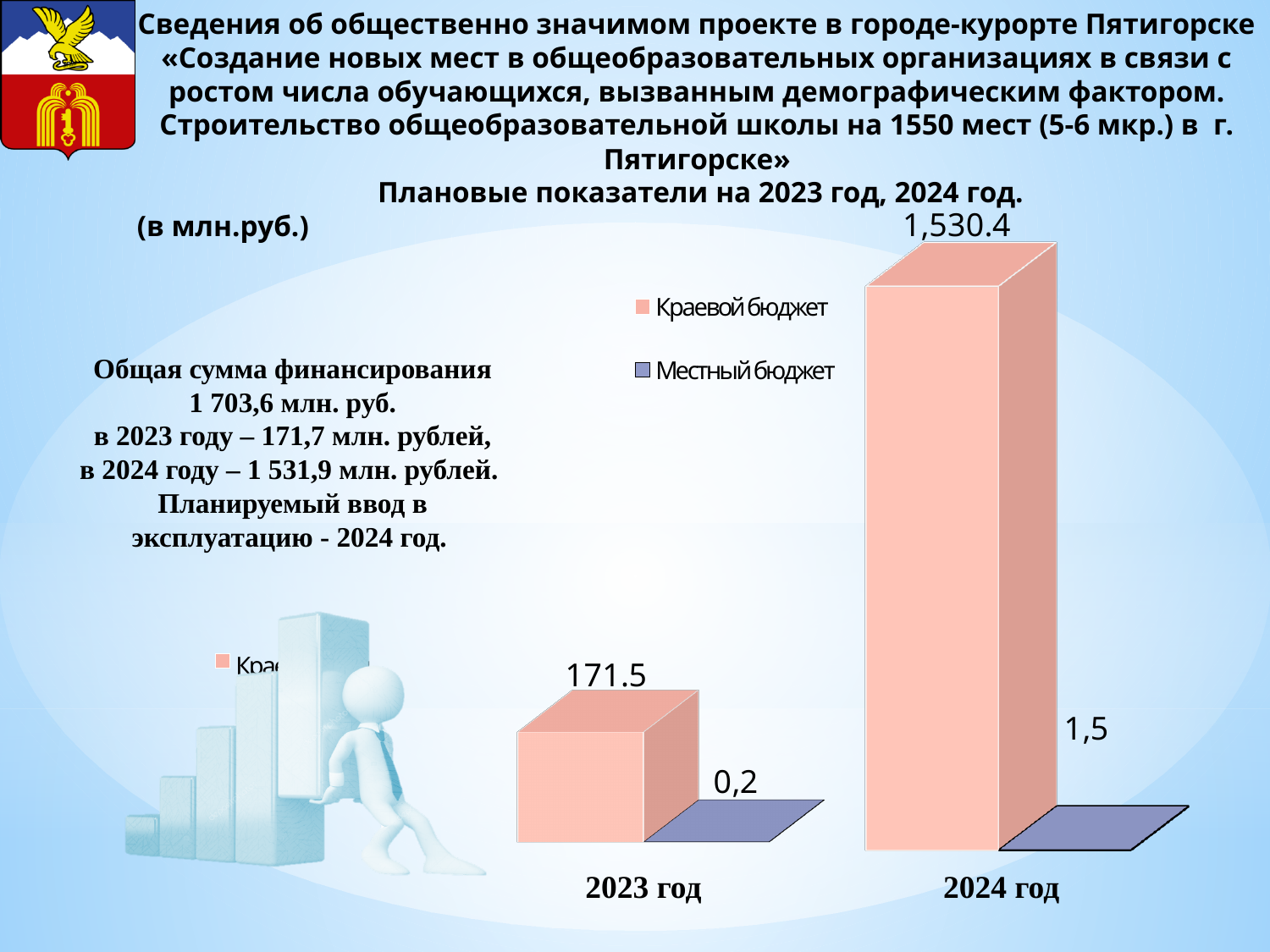
What is the value for Местный бюджет in 2023 год? 0,2 Which year has the lowest value for Местный бюджет? 2023 год What is the difference between the Местный бюджет values for 2024 год and 2023 год? 1,3 What is the value for Местный бюджет in 2024 год? 1,5 How many year categories are shown on the chart? 2 What is the value for Краевой бюджет in 2023 год? 171.5 What is the value for Краевой бюджет in 2024 год? 1,530.4 Do the Краевой бюджет values rise or fall from 2023 год to 2024 год? Rise What kind of chart is shown on the slide? Bar chart How many series does the chart legend list? 2 Which year has the highest value for Краевой бюджет? 2024 год Which is larger in 2024 год: Краевой бюджет or Местный бюджет? Краевой бюджет